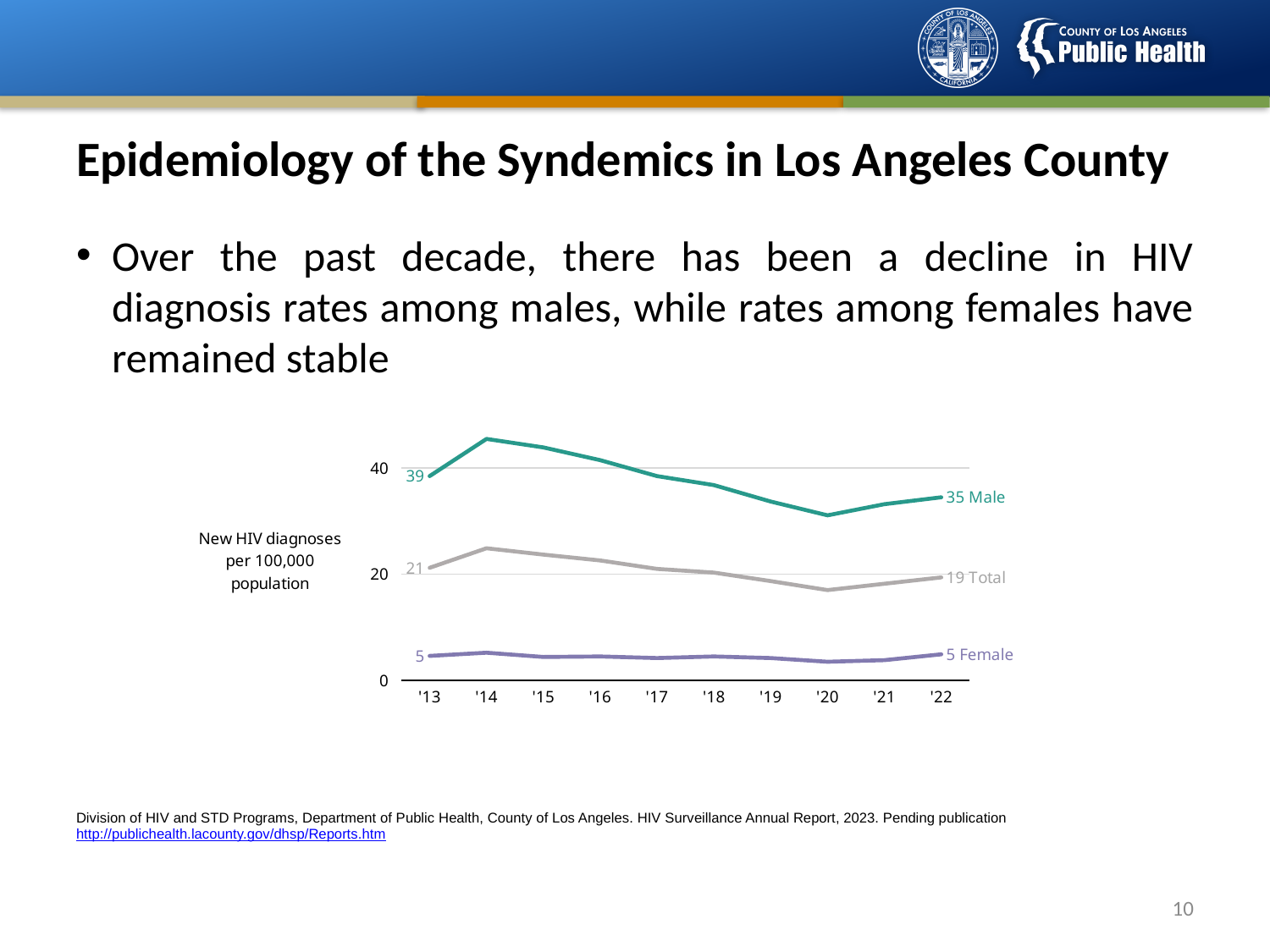
How many years are plotted on the x axis? 10 What is the difference between the Male and Female rates in '22? 30 Which series has the highest values across the chart? Male Is the Male rate in '14 greater or less than 40? greater What was the Male rate of new HIV diagnoses per 100,000 population in '22? 35 What was the Total rate of new HIV diagnoses per 100,000 population in '13? 21 What kind of chart is shown on the slide? line chart By how much did the Male rate of new HIV diagnoses decline from '13 to '22? 4 What was the Male rate of new HIV diagnoses per 100,000 population in '13? 39 What was the Total rate of new HIV diagnoses per 100,000 population in '22? 19 Which series has the lowest values across the chart? Female What was the Female rate of new HIV diagnoses per 100,000 population in '22? 5